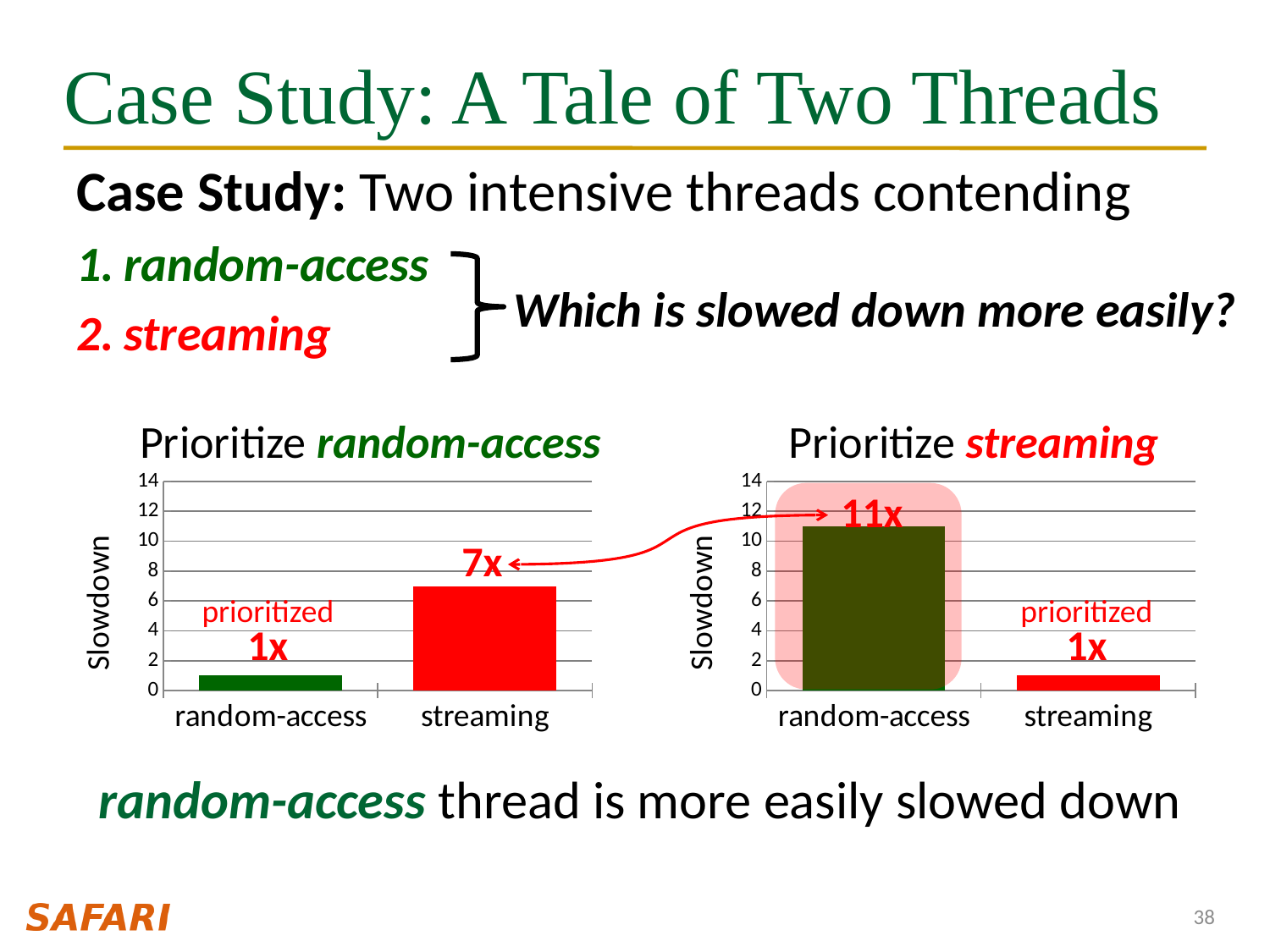
What kind of chart is the 'Prioritize streaming' chart? bar chart In the 'Prioritize random-access' chart, what is the slowdown for the streaming thread? 7x How many categories are shown on the x axis of the 'Prioritize random-access' chart? 2 In the 'Prioritize streaming' chart, what is the slowdown for the random-access thread? 11x What is the y-axis label of the 'Prioritize random-access' chart? Slowdown In the 'Prioritize random-access' chart, what is the slowdown for the random-access thread? 1x In the 'Prioritize streaming' chart, which thread has the lower slowdown? streaming In the 'Prioritize streaming' chart, what is the slowdown for the streaming thread? 1x In the 'Prioritize random-access' chart, what is the difference in slowdown between the streaming and random-access threads? 6x In the 'Prioritize streaming' chart, what is the difference in slowdown between the random-access and streaming threads? 10x In the 'Prioritize random-access' chart, which thread has the higher slowdown? streaming Is the slowdown of the random-access thread in the 'Prioritize streaming' chart greater or less than 10? greater